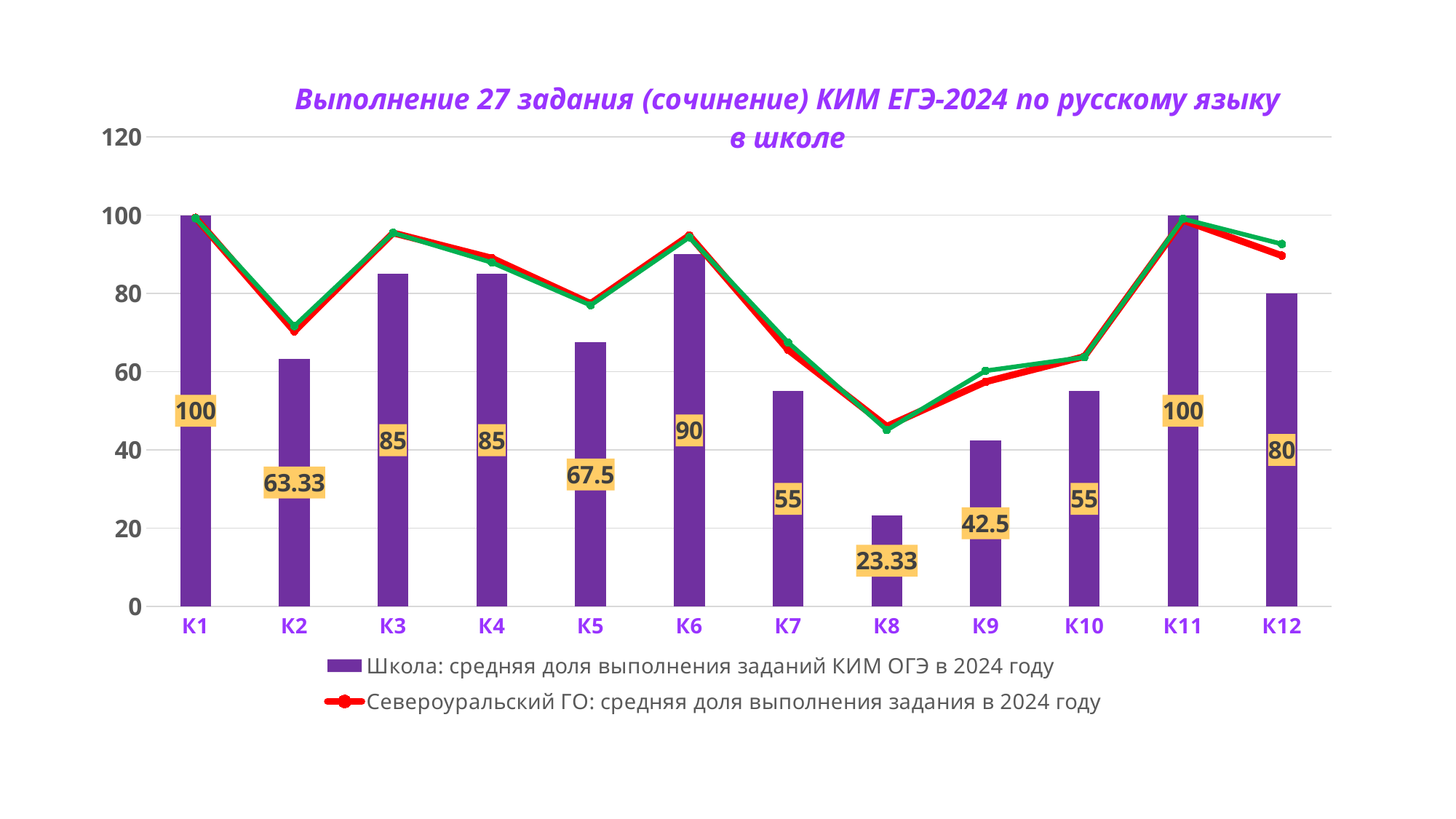
Is the Североуральский ГО line value for К12 greater or less than 80? greater What is the difference between the Школа bar values for К6 and К7? 35 What is the value of the Школа bar for К8? 23.33 Do the Школа bar values rise or fall from К6 to К8? fall What is the value of the Школа bar for К2? 63.33 Is the Североуральский ГО line value for К8 greater or less than 60? less Which Школа bar is larger, К9 or К12? К12 How many series does the legend list? 2 How many categories are shown on the x axis? 12 Which category has the lowest Школа bar? К8 What colour are the Школа bars? purple What is the value of the Школа bar for К5? 67.5